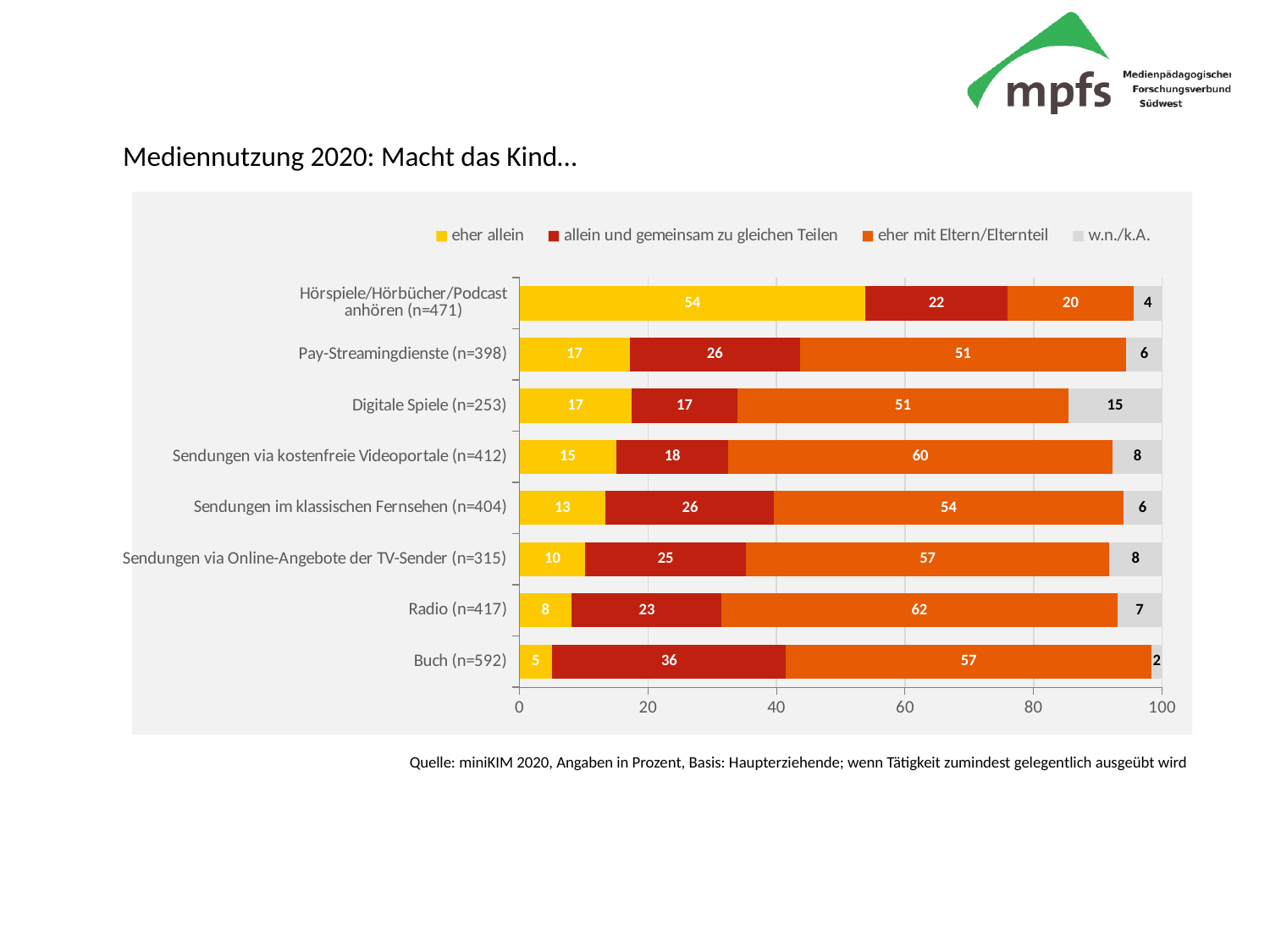
What kind of chart is shown on the slide? Stacked bar chart What is the value for "eher mit Eltern/Elternteil" for Radio (n=417)? 62 Which category has the lowest value for "eher allein"? Buch (n=592) What is the total of the stacked bar for Sendungen via kostenfreie Videoportale (n=412)? 101 What is the value for "w.n./k.A." for Digitale Spiele (n=253)? 15 What is the value for "allein und gemeinsam zu gleichen Teilen" for Buch (n=592)? 36 How many series does the legend list? 4 What is the difference between the "eher mit Eltern/Elternteil" values for Radio (n=417) and Pay-Streamingdienste (n=398)? 11 What is the value for "eher allein" for Hörspiele/Hörbücher/Podcast anhören (n=471)? 54 Which is larger: the "allein und gemeinsam zu gleichen Teilen" value for Buch (n=592) or for Radio (n=417)? Buch (n=592) How many categories are shown on the chart? 8 Which category has the highest value for "eher allein"? Hörspiele/Hörbücher/Podcast anhören (n=471)